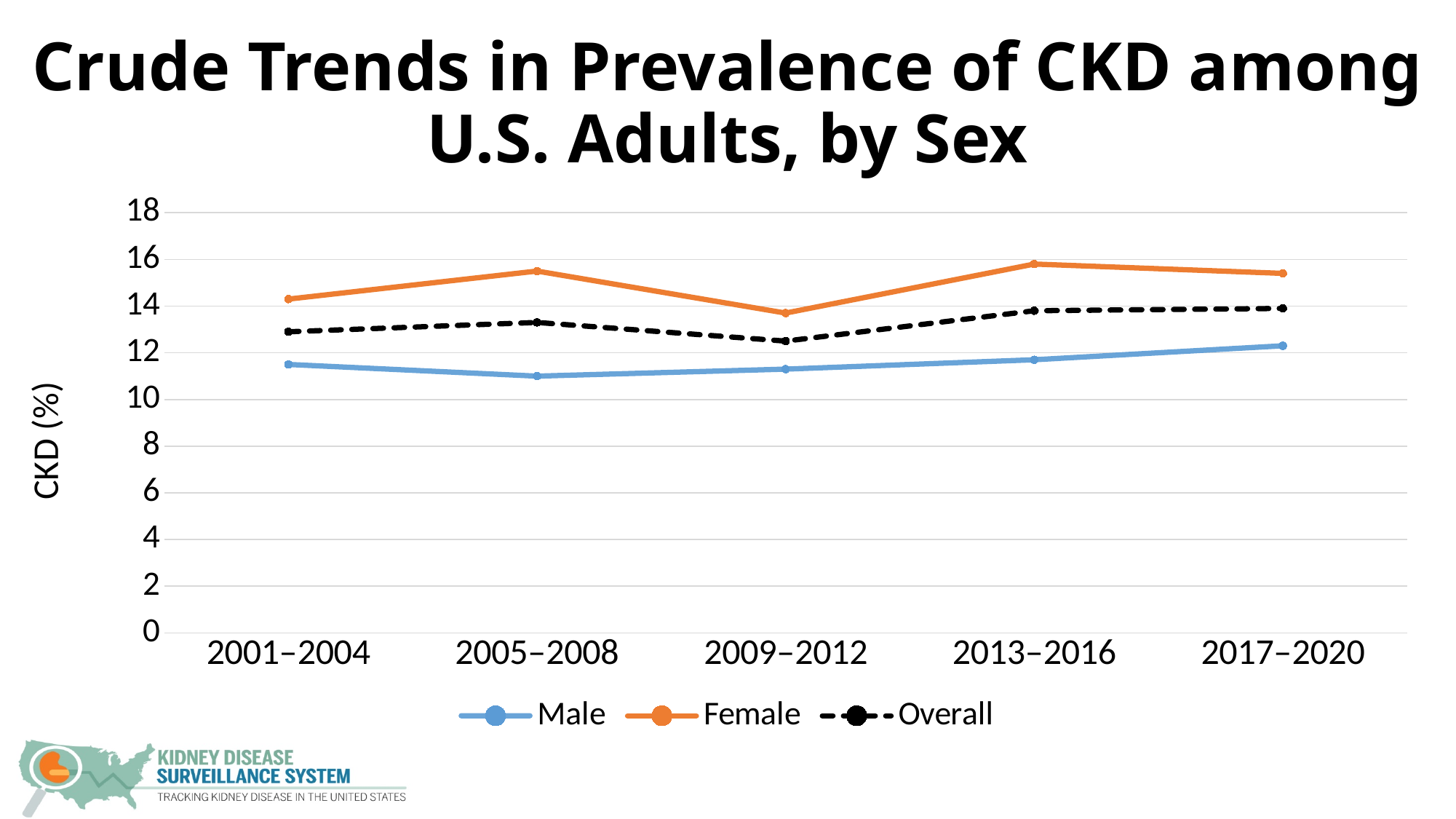
Does the Male series rise or fall from 2005–2008 to 2017–2020? rise Is the value for Male in 2005–2008 greater or less than 12? less Is the value for Male in 2001–2004 greater or less than 12? less What kind of chart is shown on the slide? line chart Is the value for Female in 2013–2016 greater or less than 14? greater How many series does the legend list? 3 In which period is the Male value highest? 2017–2020 How many time periods are shown on the x axis? 5 In which period is the Female value lowest? 2009–2012 In 2009–2012, which is larger, the Male value or the Female value? Female Which series is drawn with a dashed line? Overall